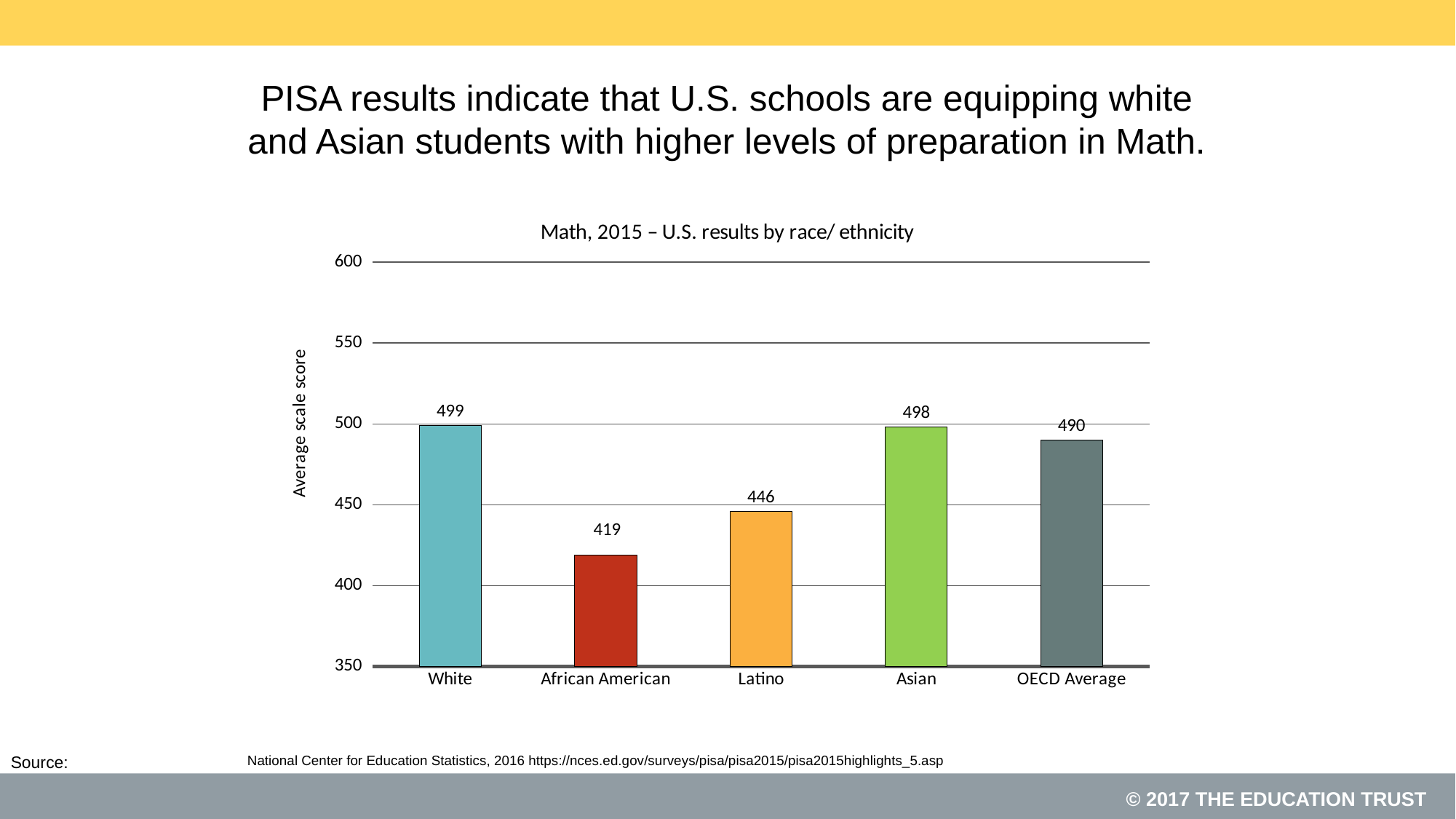
What is the difference between the Asian score and the OECD Average? 8 What kind of chart is shown on the slide? Bar chart What is the average scale score for African American students? 419 What is the average scale score for Latino students? 446 What is the difference between the White score and the African American score? 80 What is the OECD Average score shown on the chart? 490 Which category has the highest average scale score? White How many categories are shown on the x axis? 5 Which category has the lowest average scale score? African American What is the title of the chart? Math, 2015 – U.S. results by race/ ethnicity Which is larger, the Latino score or the OECD Average? OECD Average What is the average scale score for White students? 499